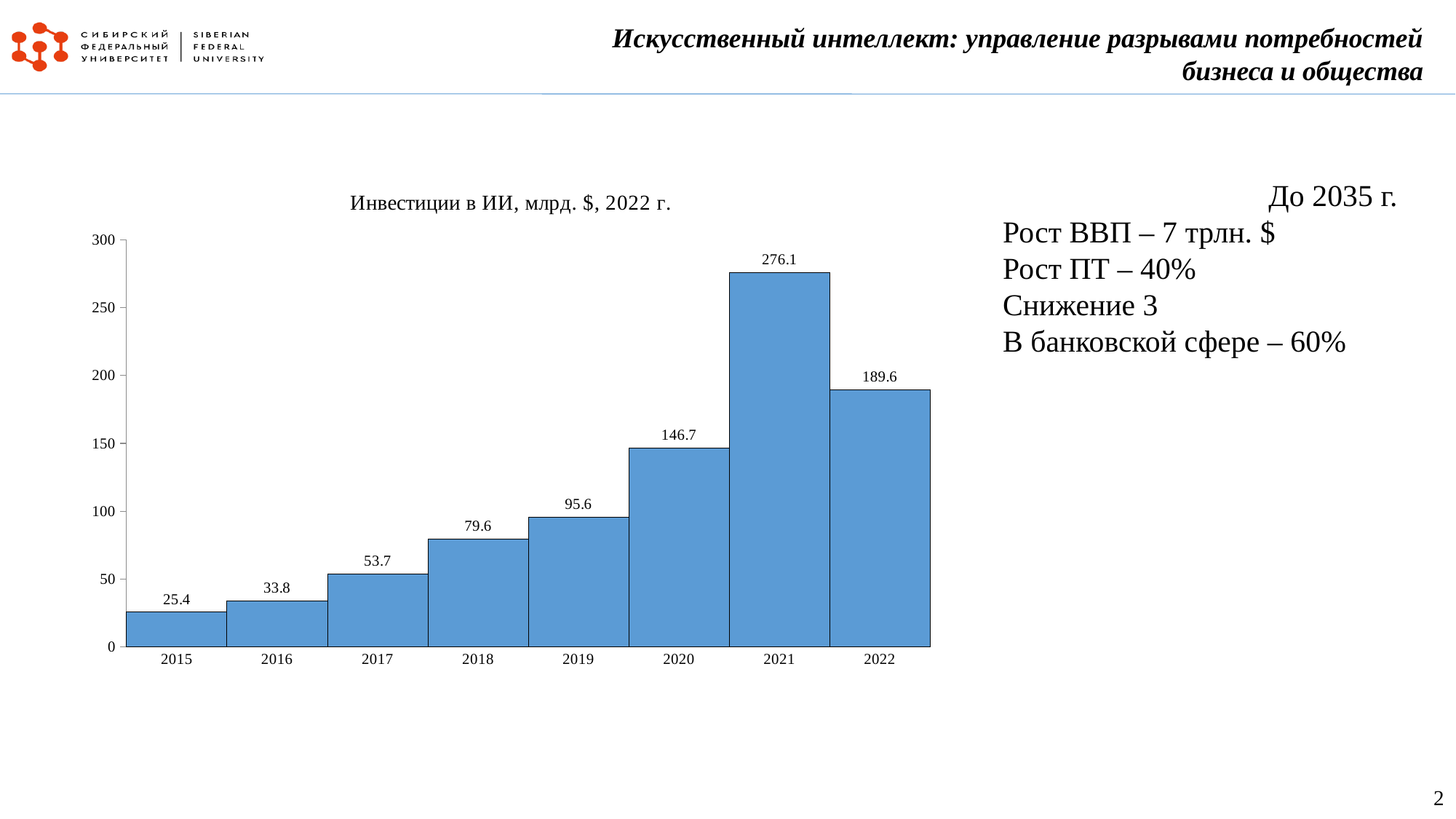
What is the difference between the values for 2020 and 2019? 51.1 What is the value for 2019? 95.6 What is the value for 2021? 276.1 Is the value for 2022 greater or less than 150? greater Which year has the highest value? 2021 Which is larger, the value for 2018 or the value for 2017? 2018 What kind of chart is this? bar chart What is the title of the chart? Инвестиции в ИИ, млрд. $, 2022 г. Which year has the lowest value? 2015 What is the difference between the values for 2021 and 2022? 86.5 What is the value for 2015? 25.4 How many years are shown on the x axis? 8